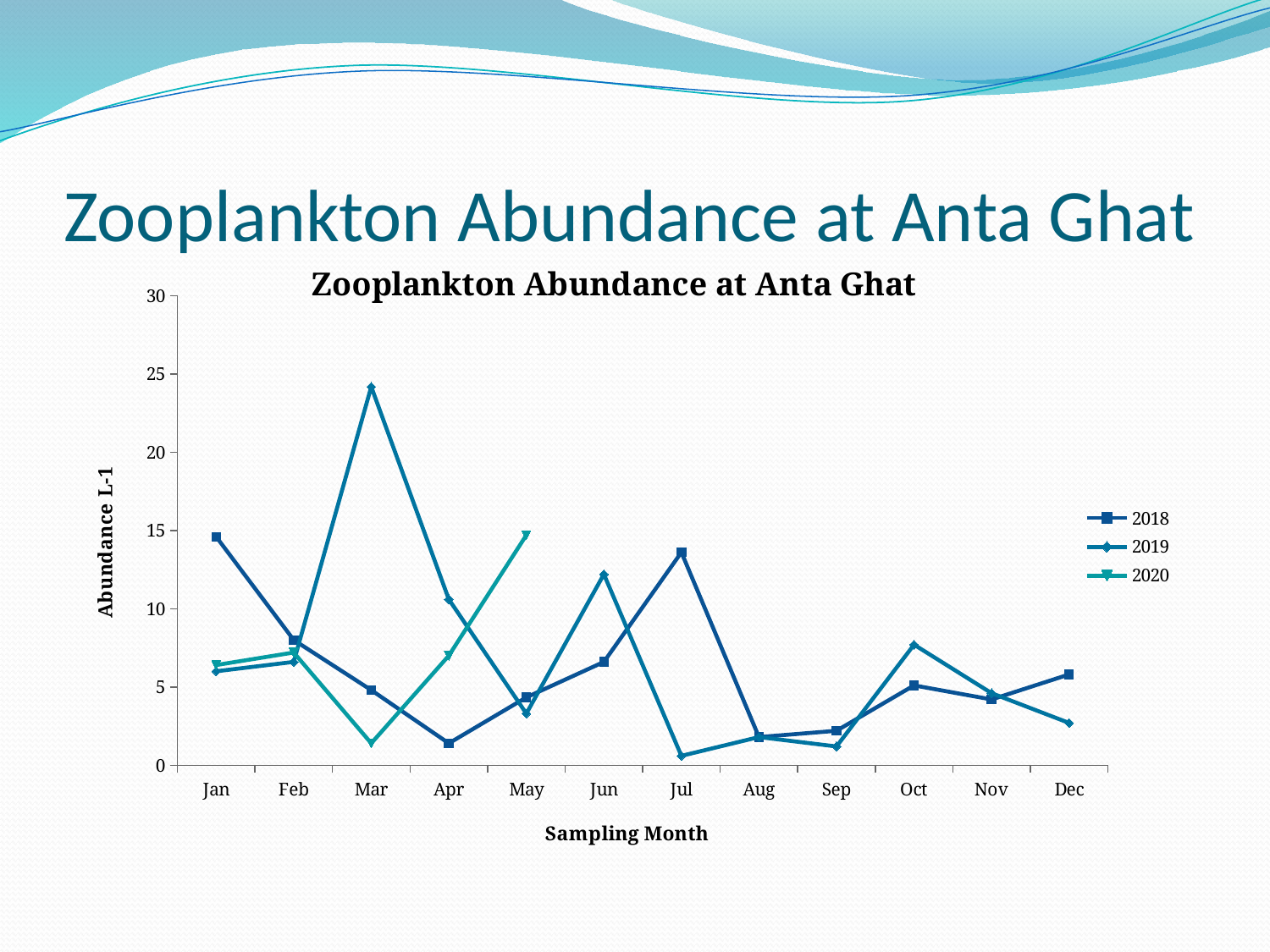
Is the value for 2018 in Jul greater or less than 10? greater How many series does the legend list? 3 Is the value for 2019 in Mar greater or less than 20? greater Is the value for 2019 in Jul greater or less than 5? less Does the 2020 series rise or fall from Mar to May? rise How many data points are plotted for the 2020 series? 5 In which month does the 2019 series reach its highest value? Mar Which series has the larger value in Mar, 2018 or 2019? 2019 What kind of chart is shown on the slide? line chart In which month does the 2020 series reach its lowest value? Mar How many months are shown on the x axis? 12 In which month does the 2020 series reach its highest value? May